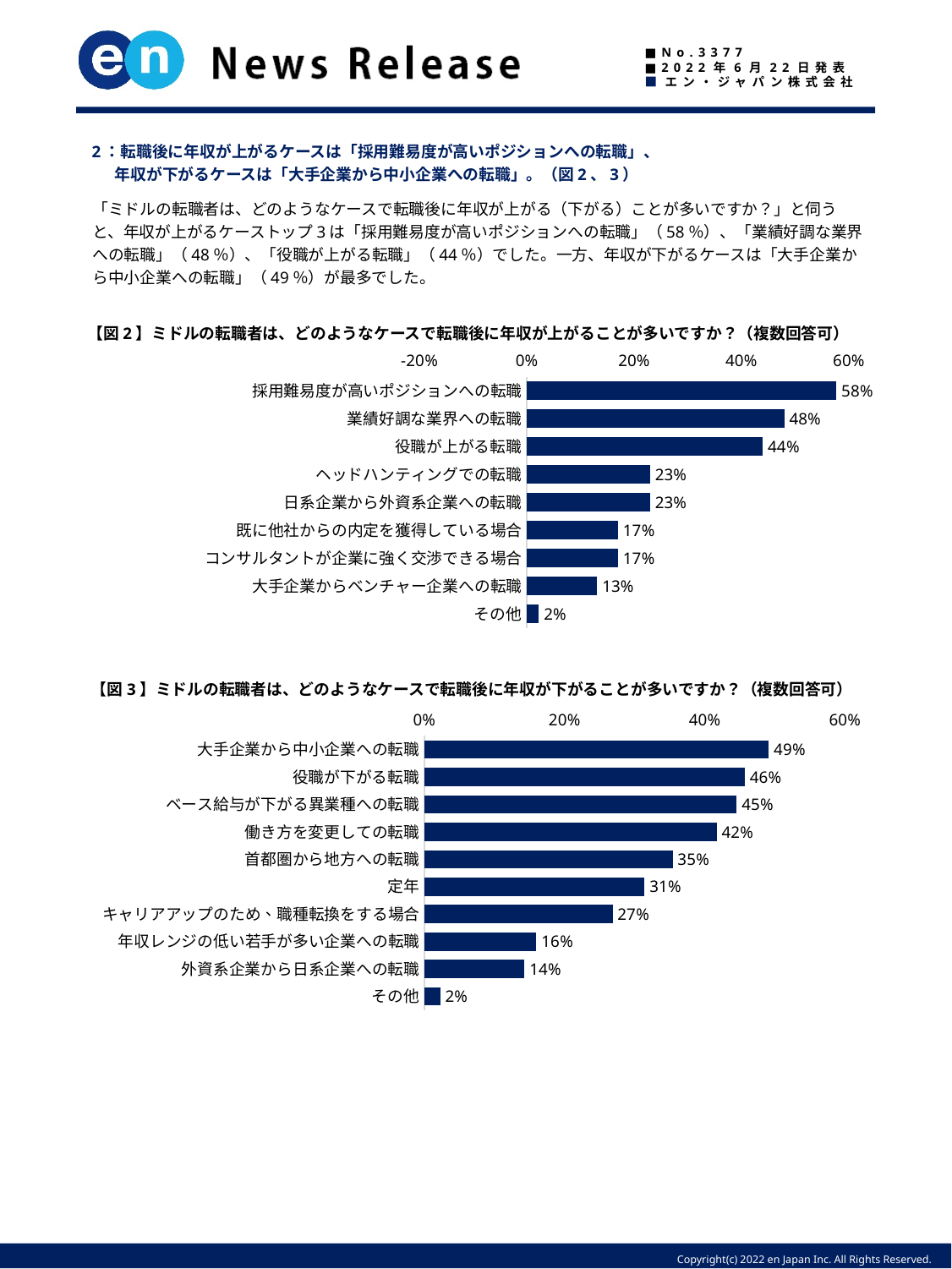
In the 【図2】 chart (top), what is the maximum value shown on the horizontal axis? 60% In the 【図3】 chart (bottom), which is larger: 定年 or キャリアアップのため、職種転換をする場合? 定年 In the 【図3】 chart (bottom), what is the difference between 大手企業から中小企業への転職 and 外資系企業から日系企業への転職? 35% In the 【図2】 chart (top), which category has the lowest value? その他 In the 【図2】 chart (top), how many categories are plotted? 9 In the 【図2】 chart (top), what is the difference between 業績好調な業界への転職 and 役職が上がる転職? 4% In the 【図2】 chart (top), what is the value for 大手企業からベンチャー企業への転職? 13% In the 【図3】 chart (bottom), how many categories are plotted? 10 In the 【図2】 chart (top), what is the value for 採用難易度が高いポジションへの転職? 58% In the 【図3】 chart (bottom), what is the value for 首都圏から地方への転職? 35% In the 【図3】 chart (bottom), which category has the highest value? 大手企業から中小企業への転職 What type of chart is the 【図3】 chart (bottom)? Bar chart